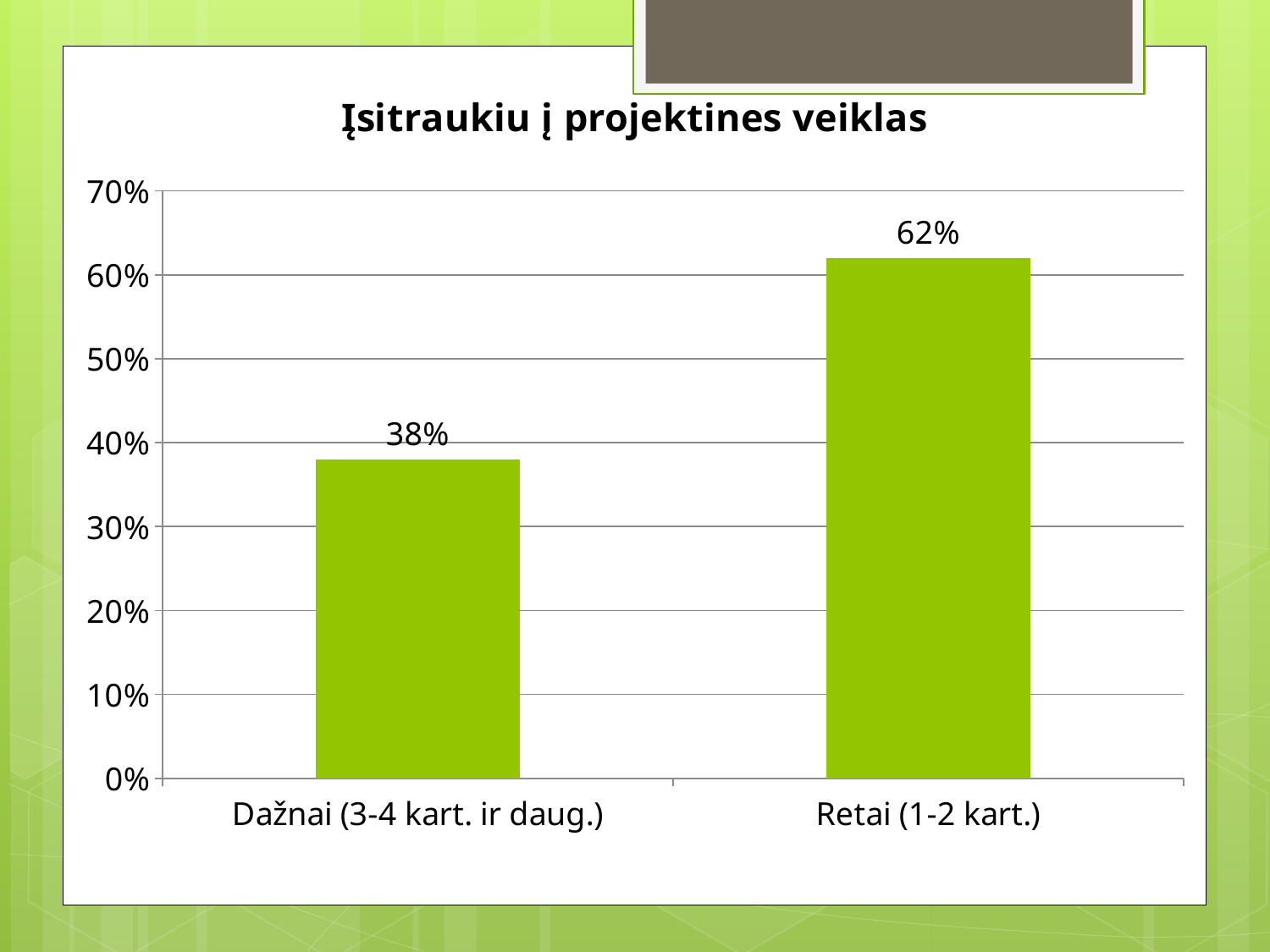
What is the difference between the values for Retai (1-2 kart.) and Dažnai (3-4 kart. ir daug.)? 24% How many categories are shown on the chart? 2 What is the value for Dažnai (3-4 kart. ir daug.)? 38% Which category has the highest value? Retai (1-2 kart.) Is the value for Retai (1-2 kart.) greater or less than 60%? greater Is the value for Dažnai (3-4 kart. ir daug.) greater or less than 40%? less What is the highest value shown on the vertical axis? 70% What is the title of the chart? Įsitraukiu į projektines veiklas Which category has the lowest value? Dažnai (3-4 kart. ir daug.) Which is larger, the value for Dažnai (3-4 kart. ir daug.) or the value for Retai (1-2 kart.)? Retai (1-2 kart.) What is the value for Retai (1-2 kart.)? 62% What kind of chart is shown on the slide? bar chart